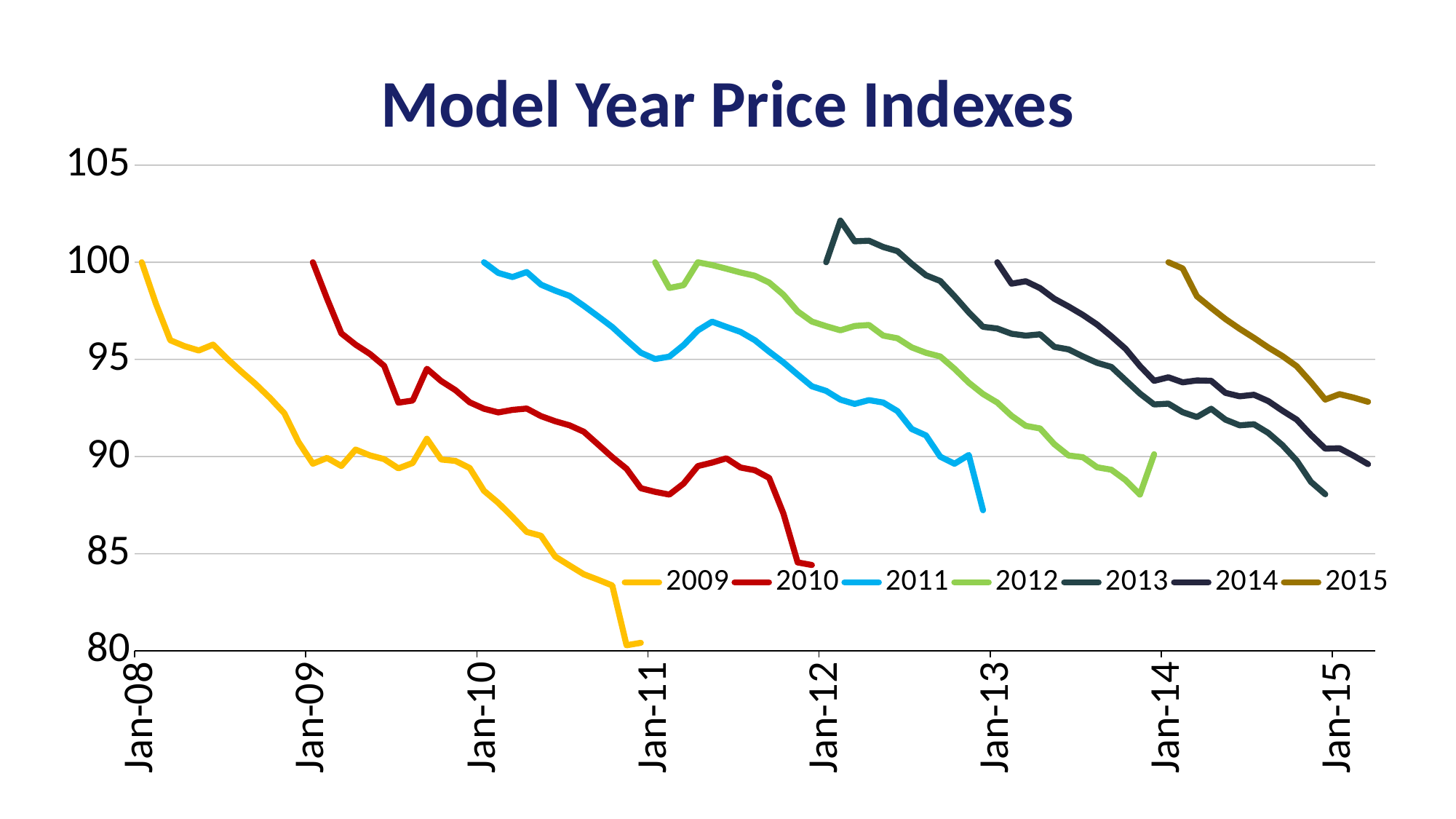
Which series reaches the highest value on the chart? 2013 What is the value of the 2015 series at Jan-14? 100 Which series reaches the lowest value on the chart? 2009 What is the value of the 2013 series at Jan-12? 100 What kind of chart is shown on the slide? line chart How many series does the legend list? 7 What is the title of the chart? Model Year Price Indexes What is the value of the 2009 series at Jan-08? 100 Is the value of the 2014 series at Jan-14 greater or less than 95? less At Jan-11, which series has the larger value, 2010 or 2012? 2012 Do the values of the 2010 series generally rise or fall along the x axis? fall Is the final value of the 2009 series greater or less than 85? less